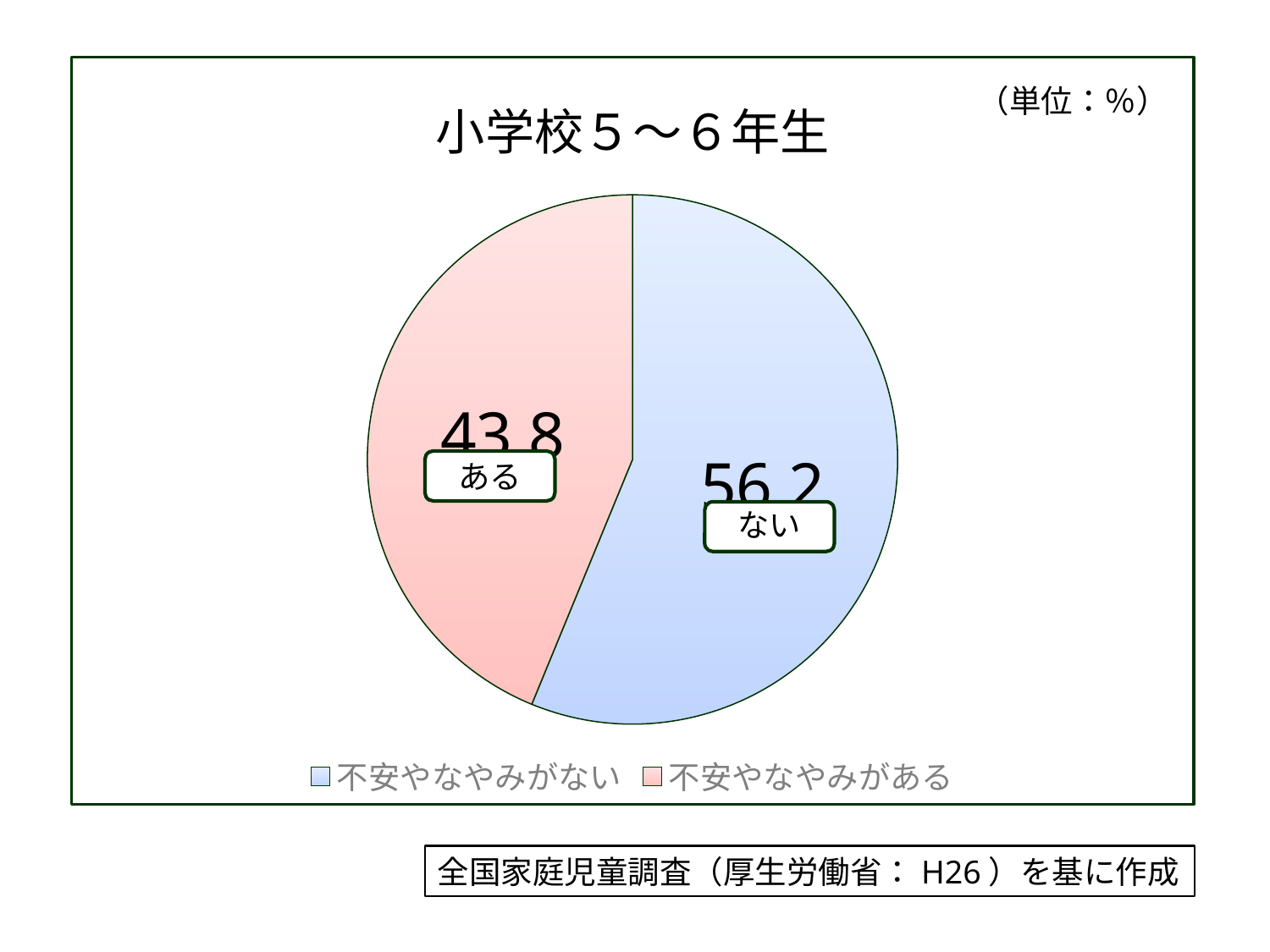
What is the value for 不安やなやみがない? 56.2 Which is larger, the value for 不安やなやみがある or the value for 不安やなやみがない? 不安やなやみがない What share of the pie does the 不安やなやみがある slice represent? 43.8% What is the value for 不安やなやみがある? 43.8 What is the difference between the values for 不安やなやみがない and 不安やなやみがある? 12.4 How many entries does the legend list? 2 Which category has the smallest slice of the pie? 不安やなやみがある What unit is indicated for the chart values? % Which category has the largest slice of the pie? 不安やなやみがない What kind of chart is shown on the slide? pie chart How many slices does the pie chart have? 2 What is the title of the chart? 小学校５～６年生